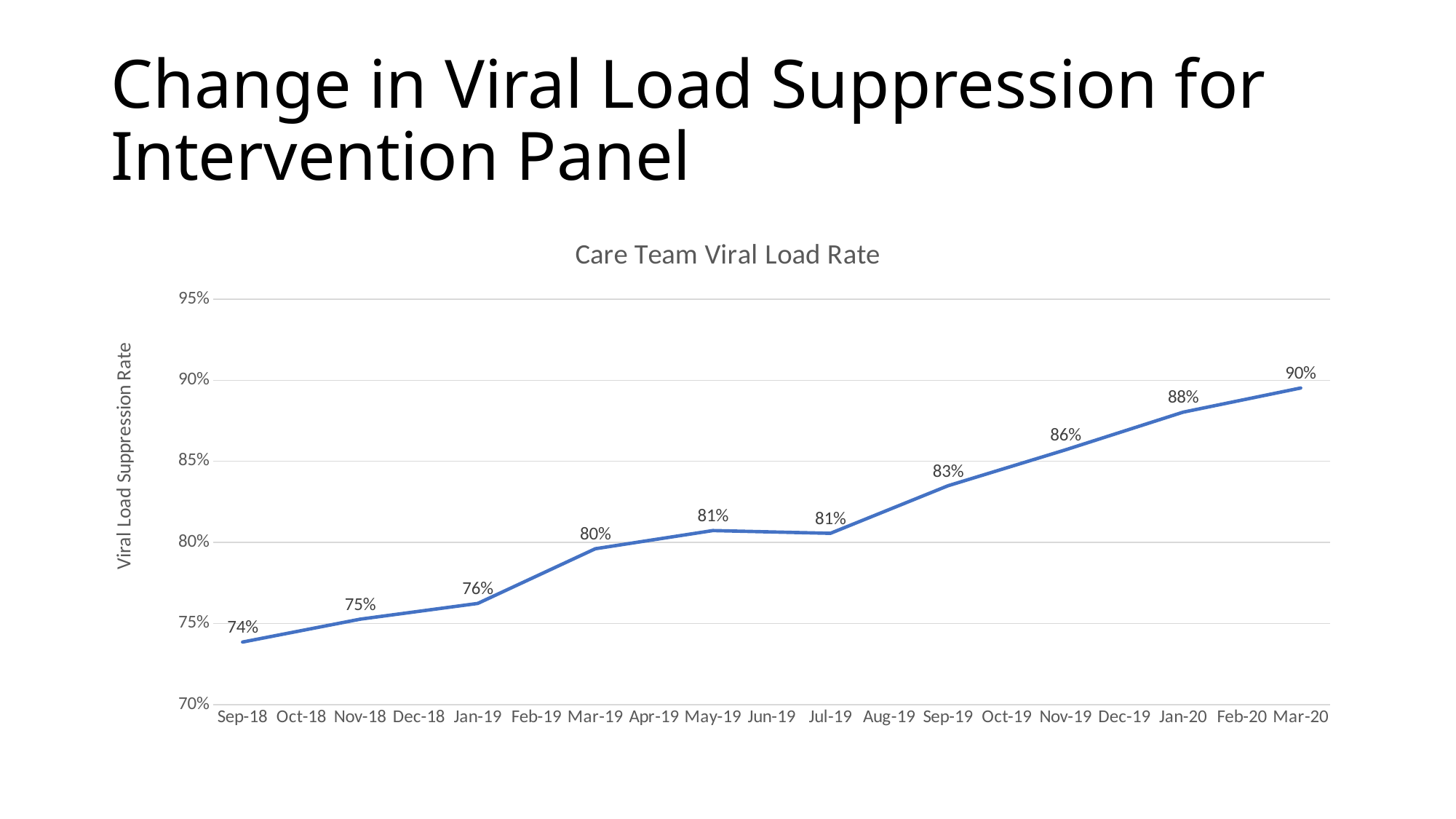
What is the viral load suppression rate for Mar-19? 80% Which month has the lowest viral load suppression rate? Sep-18 What is the difference between the viral load suppression rate in Mar-20 and in Sep-18? 16% What is the viral load suppression rate for Nov-19? 86% How many months are shown on the x axis? 19 Which month has the highest viral load suppression rate? Mar-20 What kind of chart is this? Line chart Does the viral load suppression rate generally rise or fall from Sep-18 to Mar-20? Rise What is the viral load suppression rate for Mar-20? 90% Which is larger, the viral load suppression rate in Jan-20 or in Sep-19? Jan-20 What is the viral load suppression rate for Sep-18? 74%